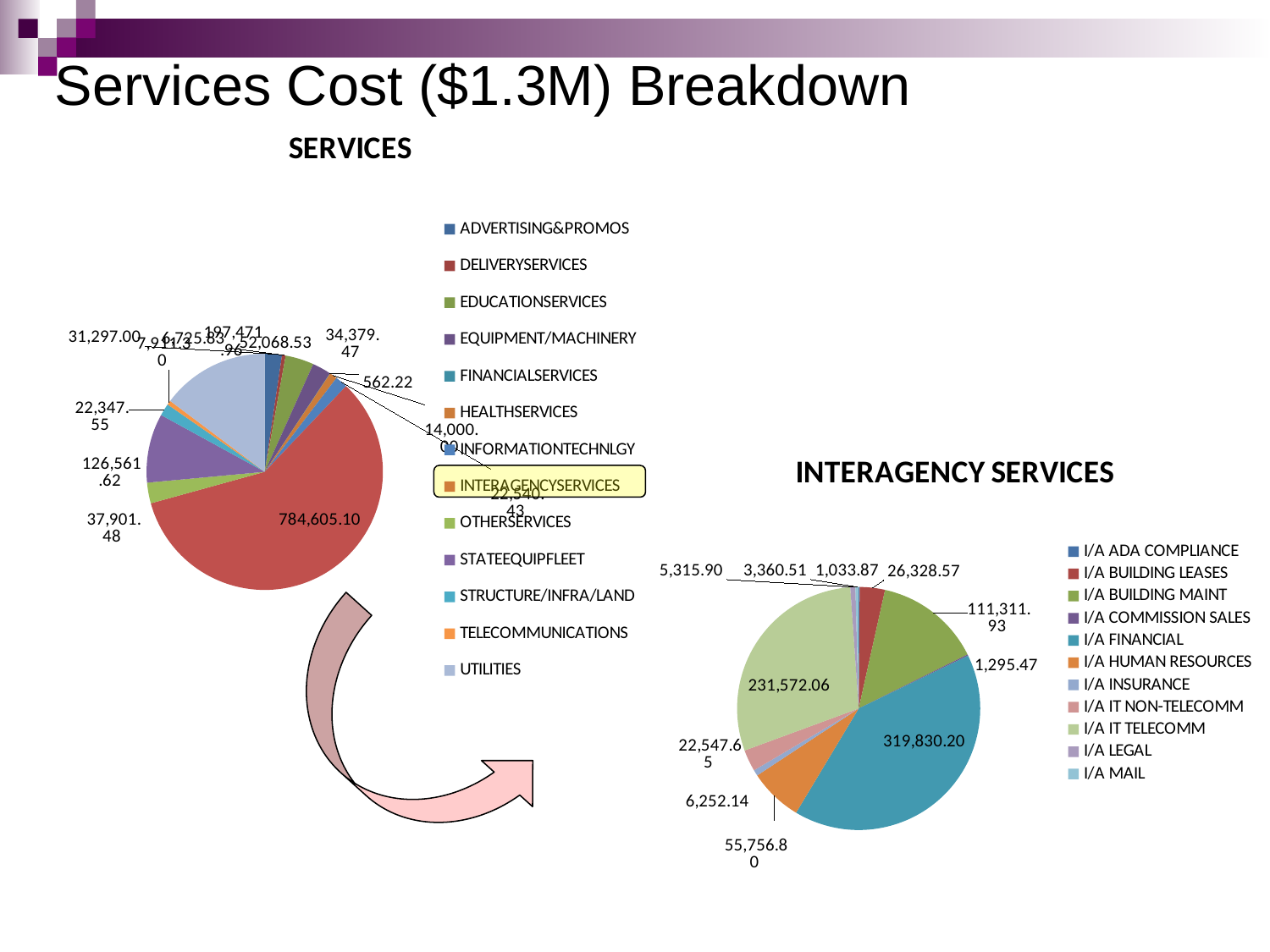
In the INTERAGENCY SERVICES chart, what is the value for I/A FINANCIAL? 319,830.20 What is the largest data label value shown on the SERVICES pie chart? 784,605.10 In the INTERAGENCY SERVICES chart, which category has the largest value? I/A FINANCIAL How many entries does the legend of the INTERAGENCY SERVICES chart list? 11 In the INTERAGENCY SERVICES chart, which category has the smallest value? I/A ADA COMPLIANCE In the INTERAGENCY SERVICES chart, which is larger: I/A BUILDING MAINT or I/A HUMAN RESOURCES? I/A BUILDING MAINT In the INTERAGENCY SERVICES chart, what is the difference between the values for I/A FINANCIAL and I/A IT TELECOMM? 88,258.14 In the INTERAGENCY SERVICES chart, what is the value for I/A IT TELECOMM? 231,572.06 What kind of chart is the INTERAGENCY SERVICES chart? Pie chart In the INTERAGENCY SERVICES chart, what is the value for I/A BUILDING MAINT? 111,311.93 How many entries does the legend of the SERVICES chart list? 13 In the INTERAGENCY SERVICES chart, what is the value for I/A HUMAN RESOURCES? 55,756.80